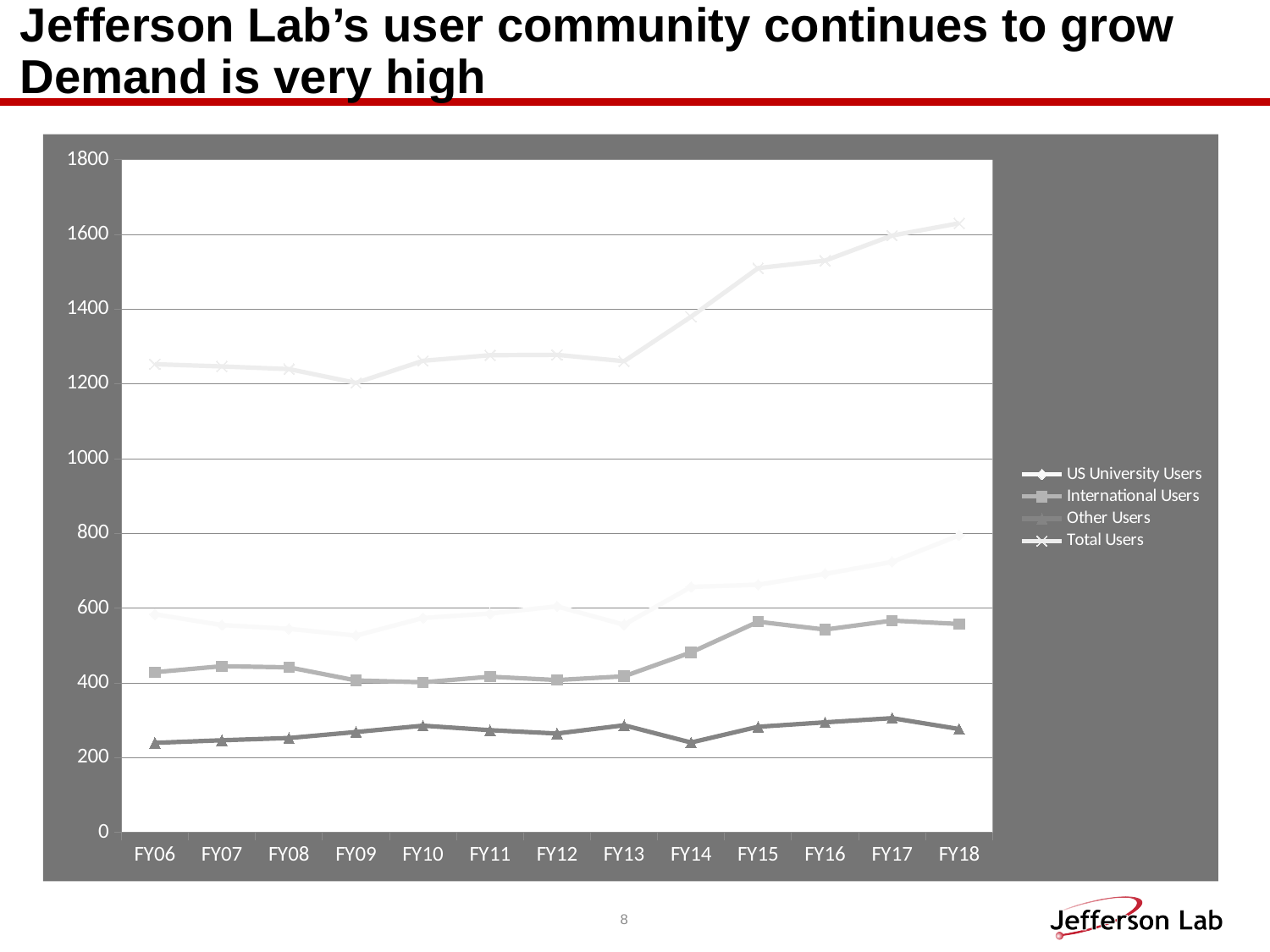
How many fiscal years are plotted along the x axis? 13 Is the value for International Users in FY10 greater or less than 600? less Is the value for Total Users in FY18 greater or less than 1400? greater How many series does the legend list? 4 Is the value for Other Users in FY18 greater or less than 600? less In which fiscal year is Total Users lowest? FY09 Which series is plotted with x-shaped markers? Total Users In which fiscal year is Total Users highest? FY18 Do Total Users rise or fall from FY13 to FY18? rise What kind of chart is shown on the slide? line chart In FY15, which is larger: International Users or US University Users? US University Users